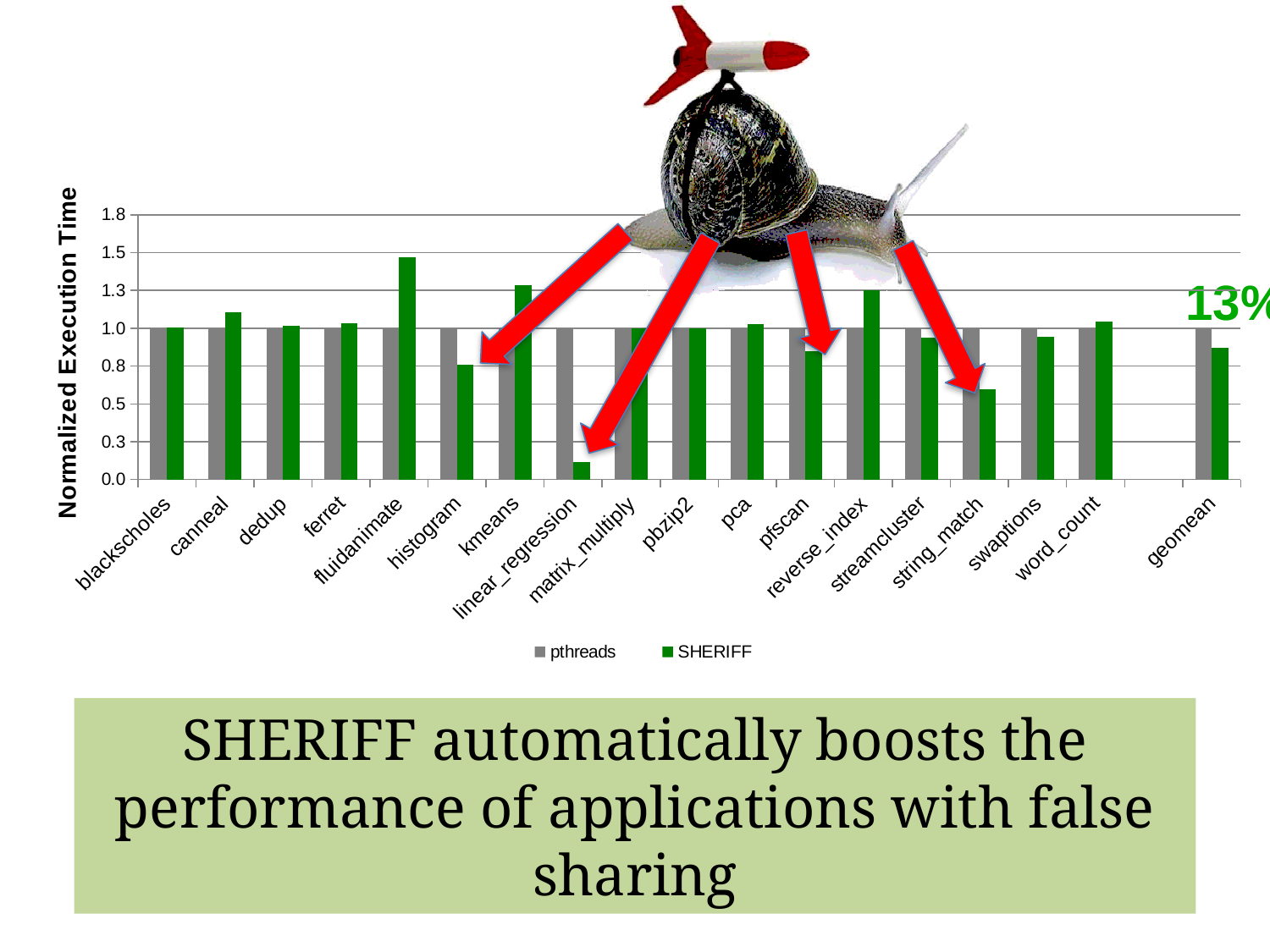
How many series does the legend list? 2 Which category has the highest SHERIFF value? fluidanimate Is the SHERIFF value for fluidanimate greater or less than 1.3? greater Which is larger, the SHERIFF value for canneal or the SHERIFF value for histogram? canneal How many categories are shown along the x axis? 18 Which category has the lowest SHERIFF value? linear_regression What are the two series named in the legend? pthreads and SHERIFF What is the pthreads value for blackscholes? 1.0 What is the label of the vertical axis? Normalized Execution Time Is the SHERIFF value for linear_regression greater or less than 0.3? less Is the SHERIFF value for string_match greater or less than 0.8? less What kind of chart is shown on the slide? bar chart